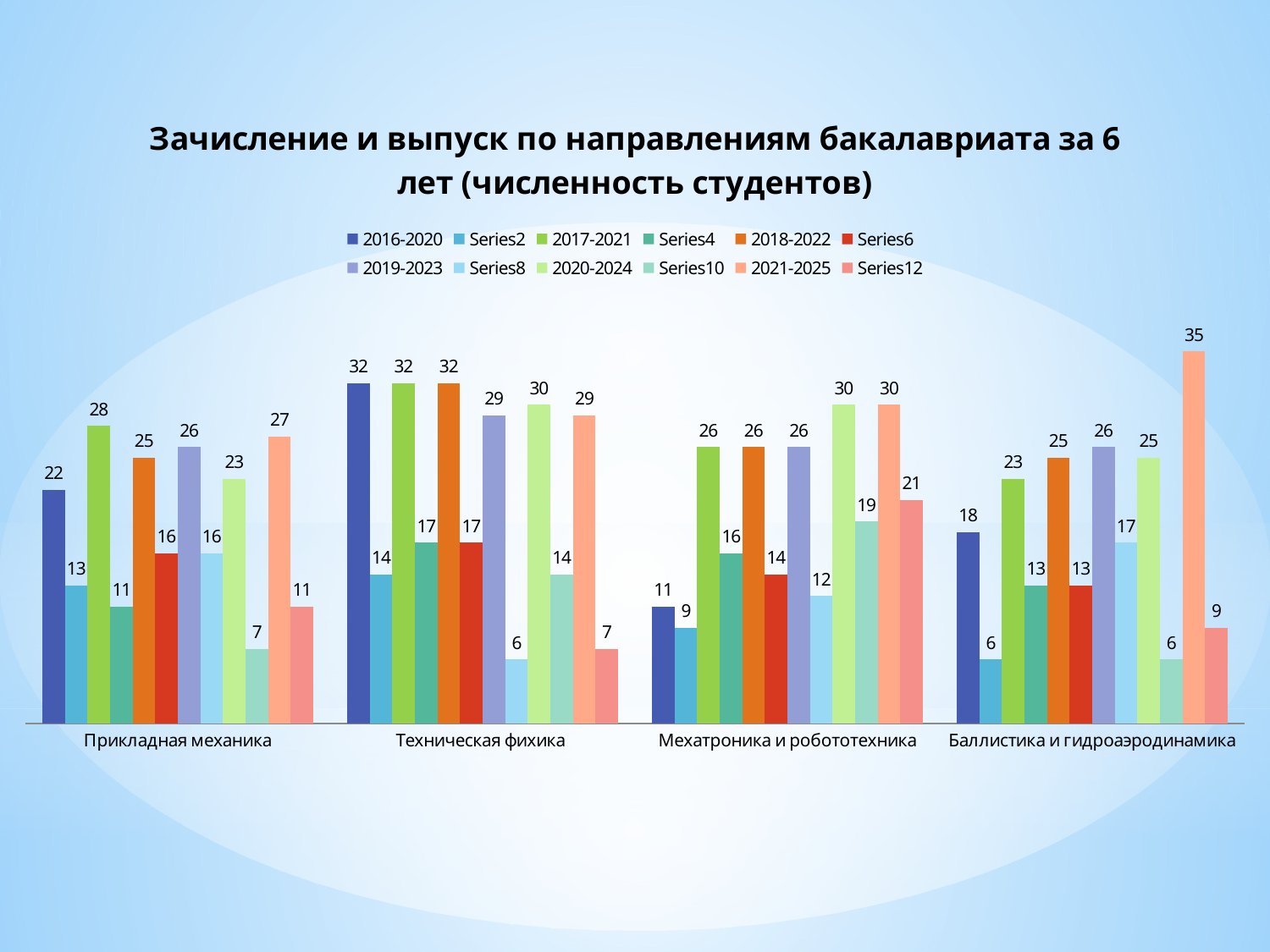
What is the value of the 2018-2022 series for Мехатроника и робототехника? 26 Which is larger: the 2020-2024 value for Мехатроника и робототехника or for Прикладная механика? Мехатроника и робототехника Which category has the lowest value for the 2016-2020 series? Мехатроника и робототехника What is the value of the 2016-2020 series for Прикладная механика? 22 Which category has the highest value for the 2021-2025 series? Баллистика и гидроаэродинамика What is the value of the 2019-2023 series for Техническая фихика? 29 What type of chart is shown on the slide? bar chart What is the difference between the 2016-2020 values for Техническая фихика and Мехатроника и робототехника? 21 What is the value of the 2021-2025 series for Баллистика и гидроаэродинамика? 35 What is the title of the chart? Зачисление и выпуск по направлениям бакалавриата за 6 лет (численность студентов) How many categories are shown along the x axis? 4 How many series does the legend list? 12